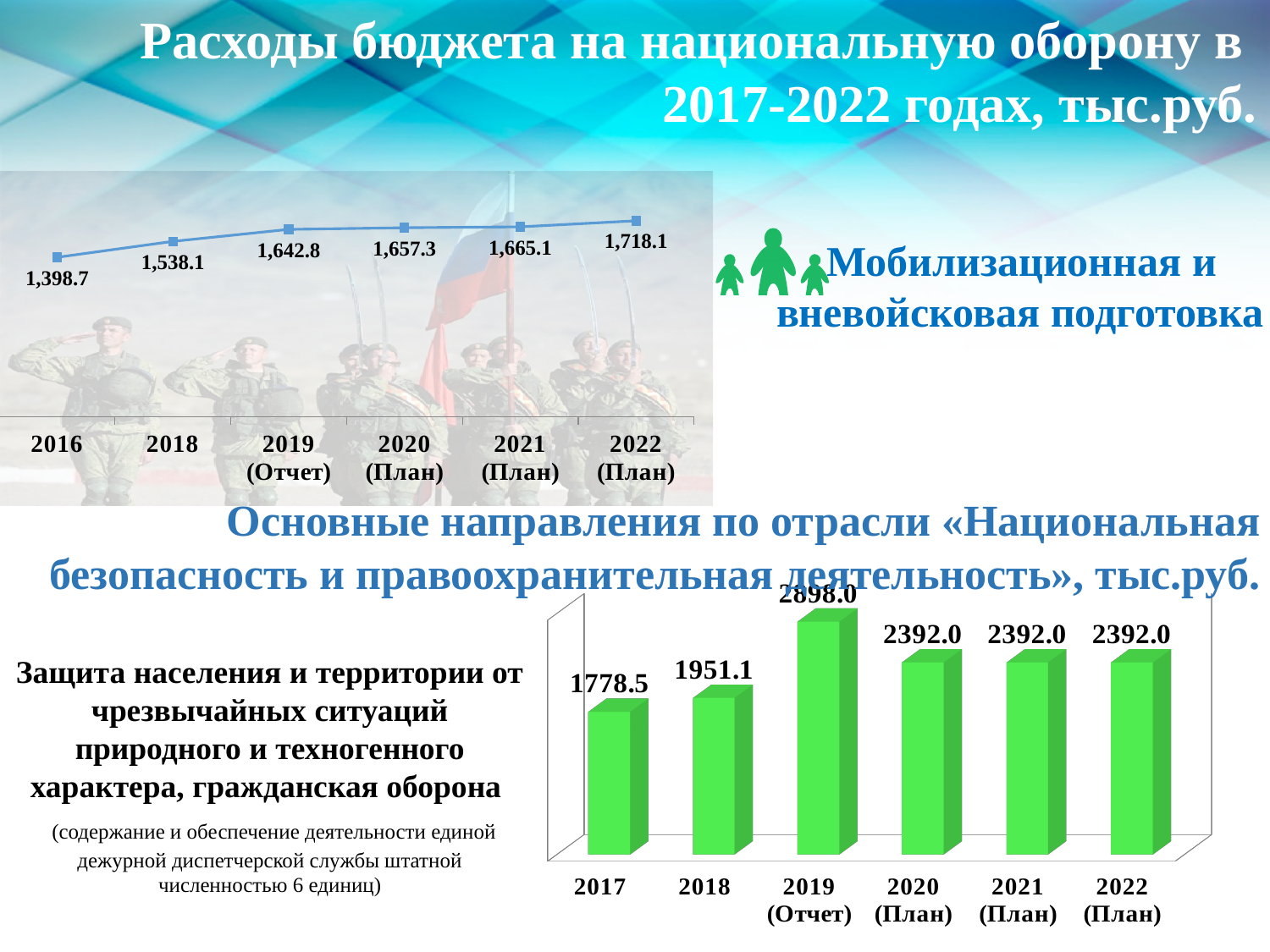
In the top line chart, which year has the lowest value? 2016 What kind of chart is the top chart on the slide? line chart What kind of chart is the bottom chart on the slide? bar chart In the bottom bar chart, what is the value for 2018? 1951.1 In the bottom bar chart, what is the difference between the values for 2019 (Отчет) and 2020 (План)? 506.0 In the top line chart, what is the difference between the values for 2022 (План) and 2016? 319.4 In the top line chart, do the values rise or fall from left to right? rise In the bottom bar chart, which year has the highest value? 2019 (Отчет) In the top line chart, what is the value for 2016? 1,398.7 In the top line chart, what is the value for 2022 (План)? 1,718.1 In the bottom bar chart, how many bars are there? 6 In the bottom bar chart, which year has the lowest value? 2017